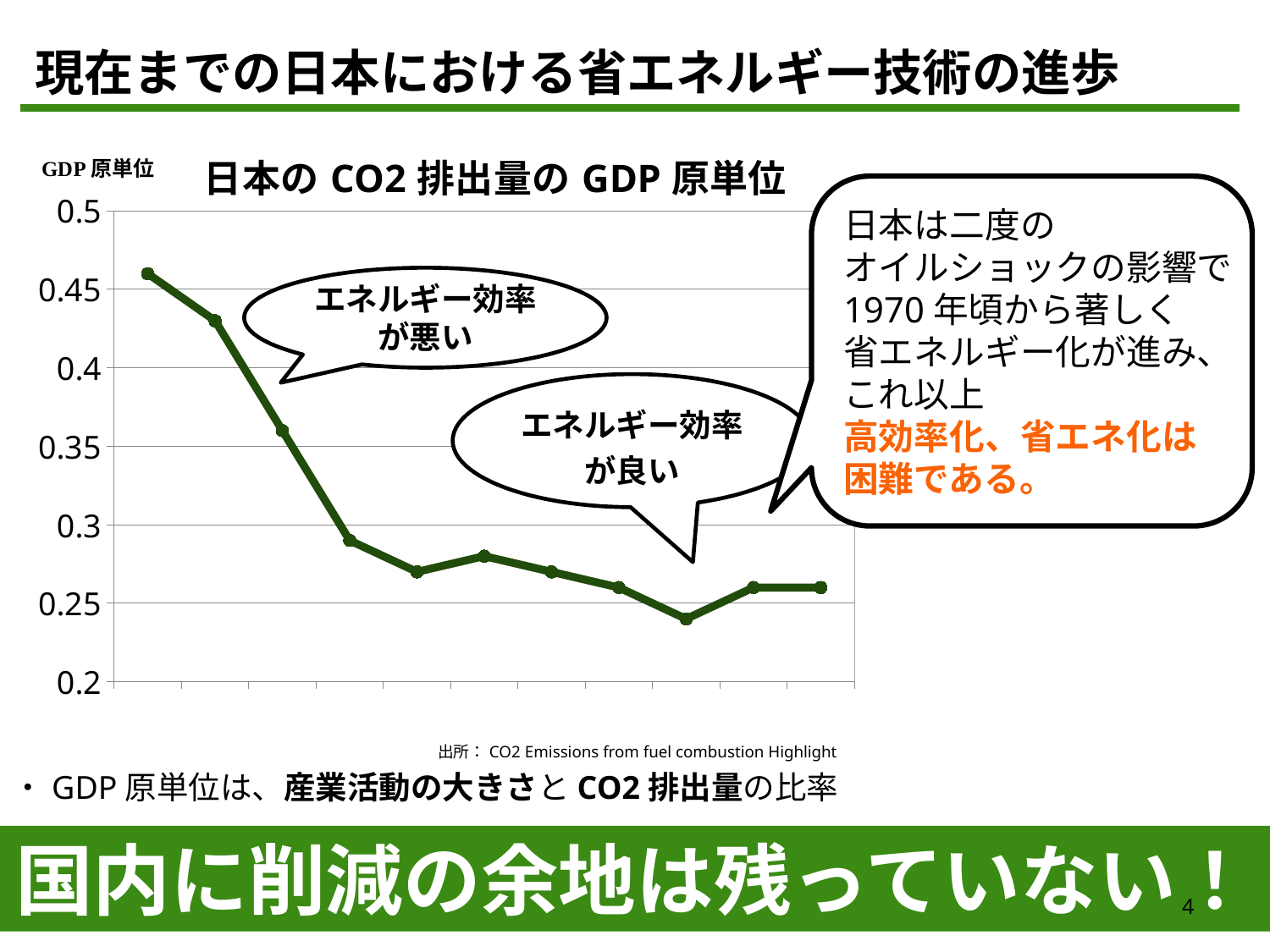
Is the lowest point on the line greater or less than 0.25? less What is the title of the chart? 日本の CO2 排出量の GDP 原単位 Which point on the line has the highest value? the leftmost (first) point How many data points are plotted on the line? 11 What label is shown on the vertical axis of the chart? GDP 原単位 What kind of chart is shown on the slide? line chart Is the value of the rightmost (last) point greater or less than 0.3? less Do the values generally rise or fall from left to right along the x axis? fall What is the highest value shown on the vertical axis? 0.5 Which is larger, the value of the first point or the value of the last point? the first point Is the value of the leftmost (first) point greater or less than 0.4? greater